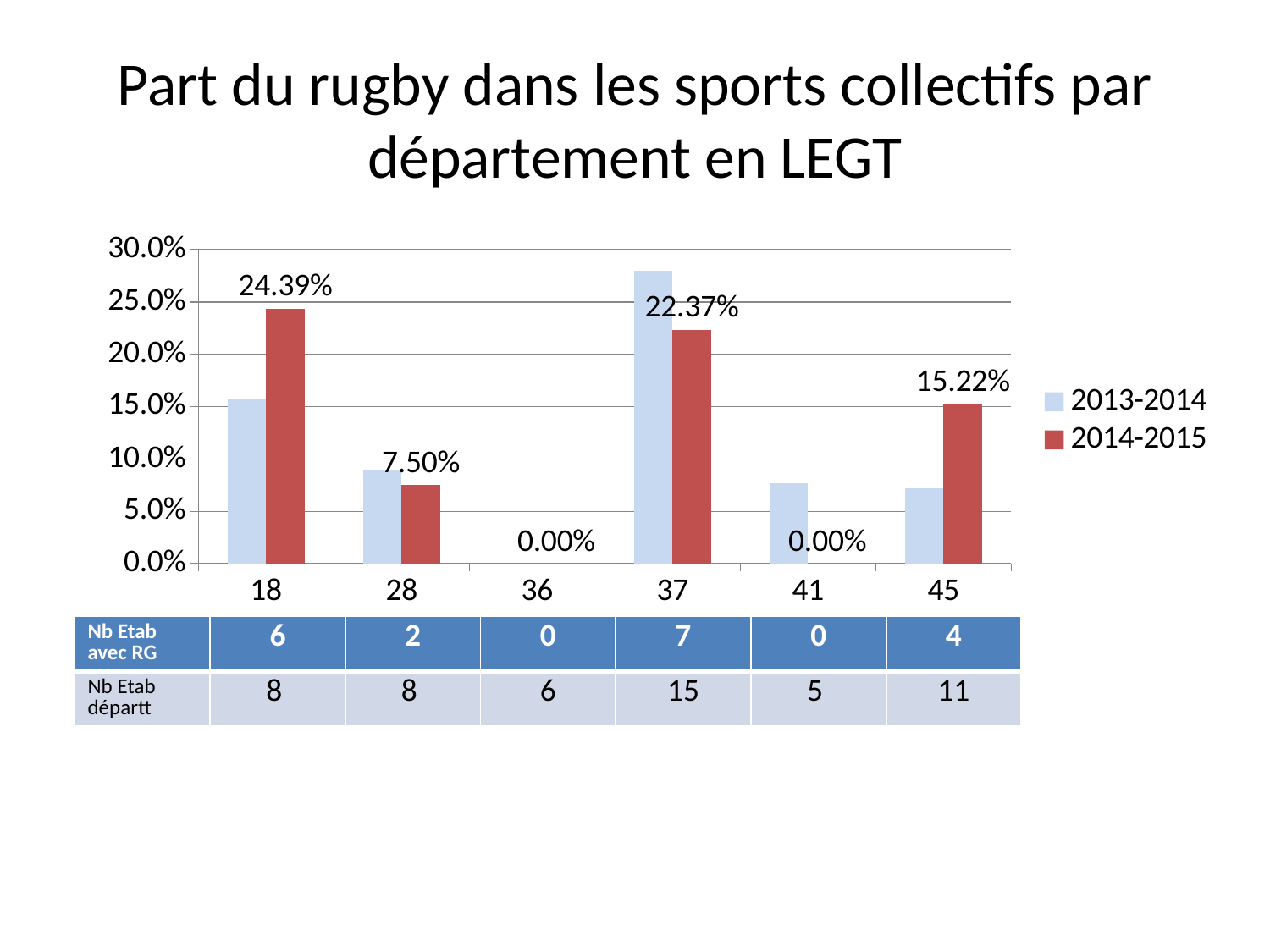
Is the 2013-2014 value for department 18 greater or less than 20.0%? less What is the difference between the 2014-2015 values for departments 18 and 37? 2.02 percentage points Which department has the highest 2014-2015 value? 18 What is the 2014-2015 value for department 45? 15.22% What is the 2014-2015 value for department 36? 0.00% For department 37, which series has the larger value, 2013-2014 or 2014-2015? 2013-2014 What kind of chart is shown on the slide? Bar chart How many series does the legend list? 2 Is the 2013-2014 value for department 37 greater or less than 25.0%? greater How many departments are shown on the x axis of the chart? 6 Which department has the larger 2014-2015 value, 28 or 45? 45 What is the 2014-2015 value for department 18? 24.39%